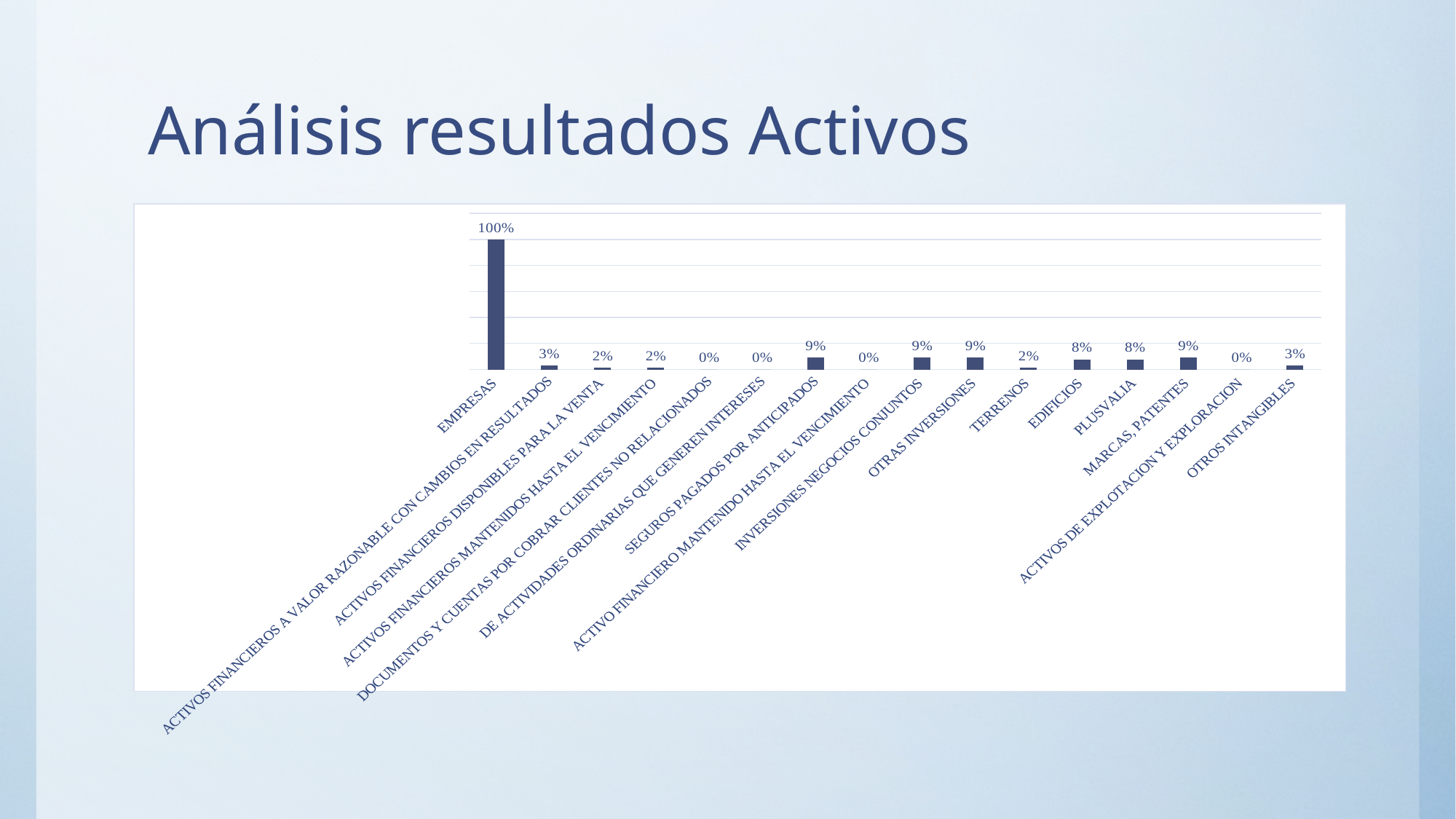
What is the value for PLUSVALIA? 8% What is the value for EMPRESAS? 100% What is the difference between the values for EMPRESAS and MARCAS, PATENTES? 91% How many categories are shown on the x axis? 16 What is the value for TERRENOS? 2% Which is larger, the value for OTRAS INVERSIONES or the value for EDIFICIOS? OTRAS INVERSIONES Which category has the highest value? EMPRESAS What kind of chart is shown on the slide? Bar chart What is the value for ACTIVOS DE EXPLOTACION Y EXPLORACION? 0% What is the difference between the values for EDIFICIOS and TERRENOS? 6% What is the value for SEGUROS PAGADOS POR ANTICIPADOS? 9% What is the value for OTROS INTANGIBLES? 3%